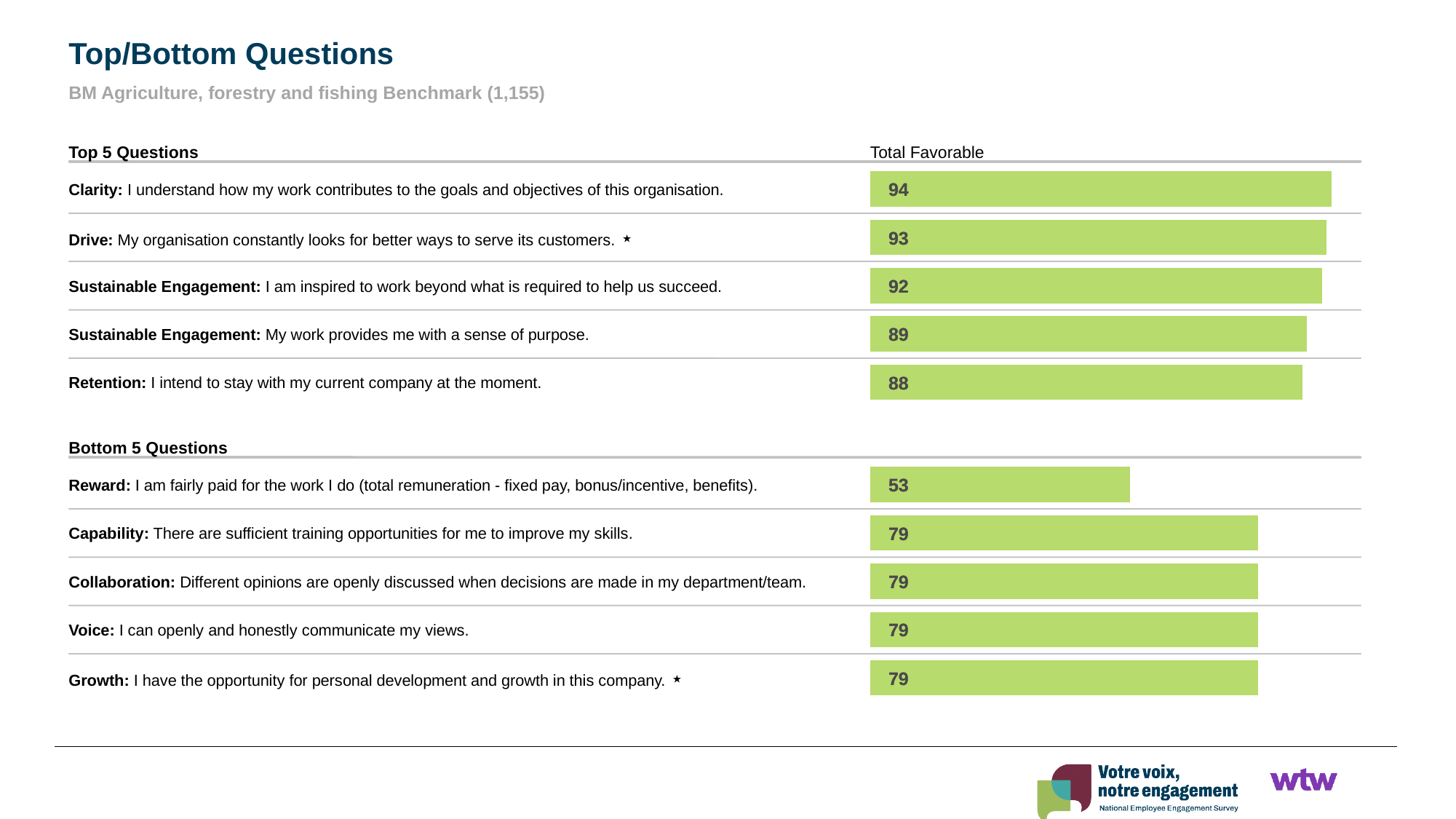
In the Top 5 Questions chart, which is larger: the Drive value or the Sustainable Engagement 'sense of purpose' value? Drive In the Bottom 5 Questions chart, what is the Total Favorable value for the Capability question? 79 In the Top 5 Questions chart, what is the Total Favorable value for the Retention question? 88 In the Bottom 5 Questions chart, what is the difference between the Capability value and the Reward value? 26 In the Top 5 Questions chart, which question has the highest Total Favorable value? Clarity In the Top 5 Questions chart, what is the difference between the Clarity value and the Retention value? 6 How many questions are shown in the Bottom 5 Questions chart? 5 What is the benchmark named in the subtitle of the slide? BM Agriculture, forestry and fishing Benchmark (1,155) In the Top 5 Questions chart, what is the Total Favorable value for the Clarity question? 94 In the Bottom 5 Questions chart, what is the Total Favorable value for the Reward question? 53 In the Bottom 5 Questions chart, which question has the lowest Total Favorable value? Reward What kind of chart is used to show the Total Favorable values on the slide? Bar chart